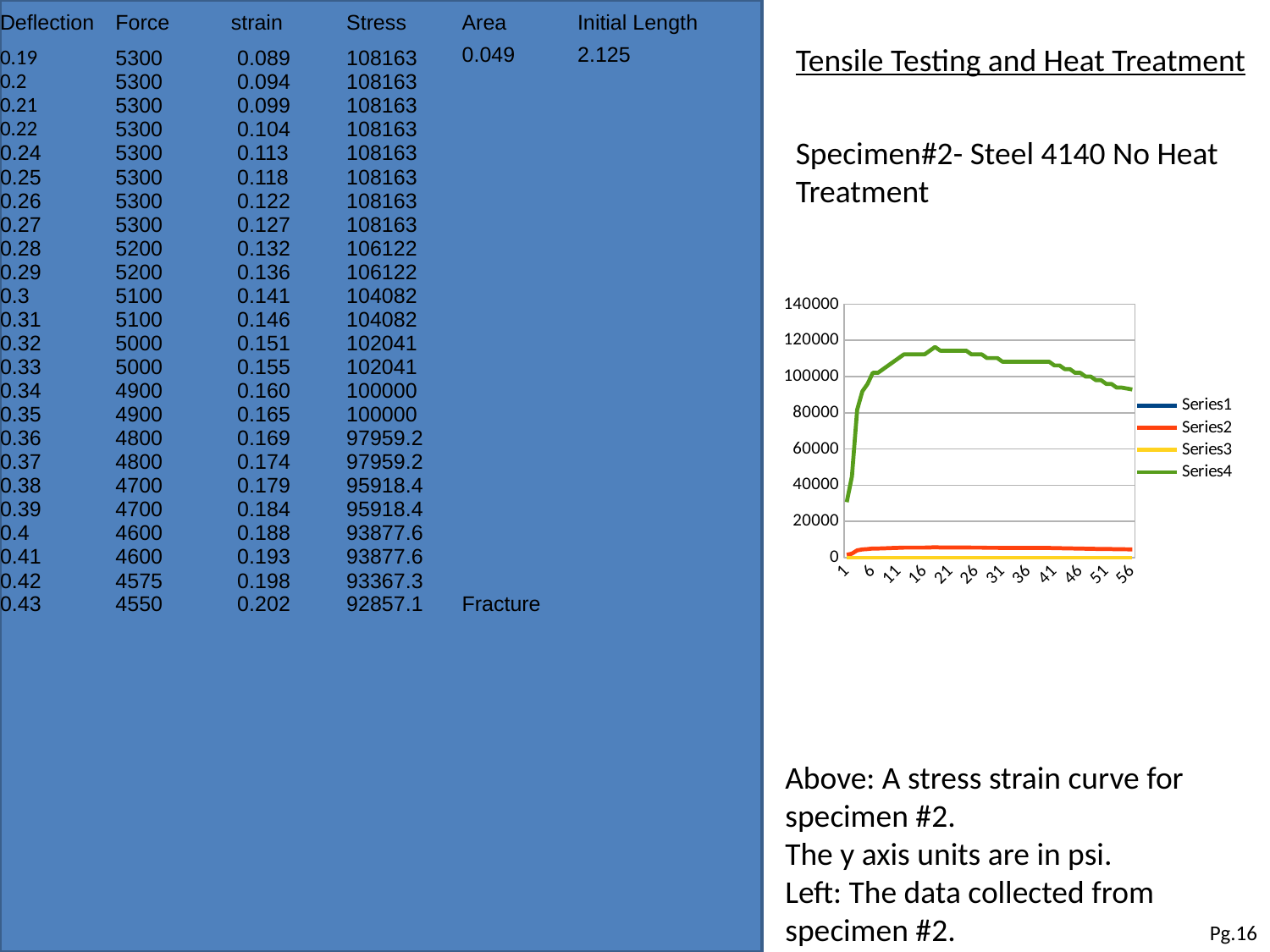
At x = 26, which is larger, Series4 or Series2? Series4 Is the peak value of Series4 greater or less than 100000? greater What kind of chart is shown on the slide? line chart Does Series4 rise or fall along the x axis from x = 21 to x = 56? fall Are the values of Series2 greater or less than 20000 across the chart? less Which series has the highest values in the chart? Series4 Is the value of Series4 at x = 56 greater or less than 100000? less What colour is the line for Series4 in the chart? green How many tick labels are shown on the chart's x axis? 12 What is the highest value labelled on the chart's y axis? 140000 How many series does the chart's legend list? 4